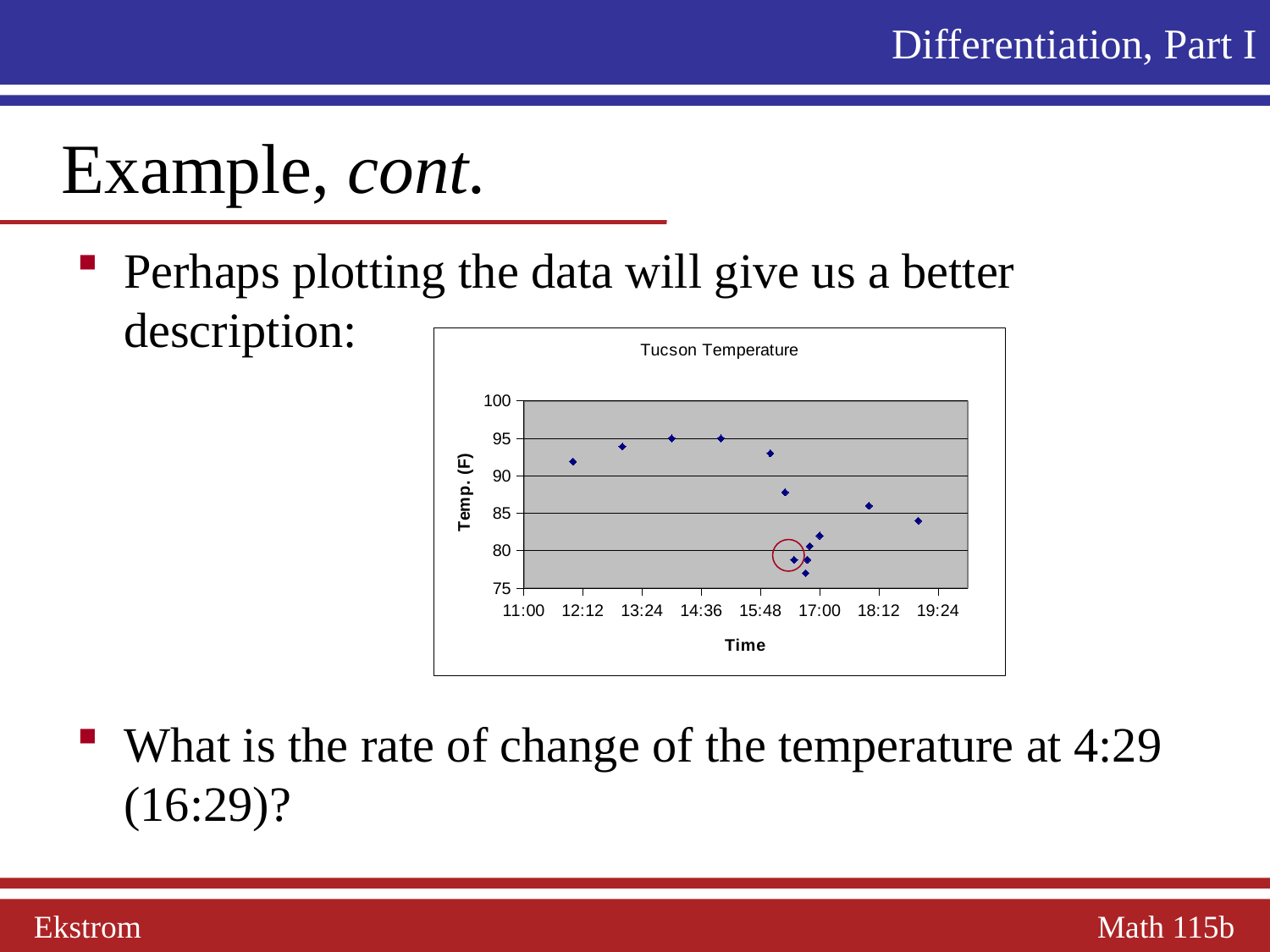
What kind of chart is shown on the slide? scatter plot Is the value of the rightmost data point (near 19:00) greater or less than 90? less What is the label of the vertical axis of the chart? Temp. (F) Which is larger, the temperature of the leftmost data point or the temperature of the rightmost data point? the leftmost data point Is the value of the data point near 18:00 greater or less than 90? less Is the value of the circled data point greater or less than 85? less Do the temperatures rise or fall between 12:12 and 14:36? rise Which is larger, the temperature of the circled data point or the temperature of the data point near 18:00? the data point near 18:00 Do the temperatures rise or fall between 15:48 and 17:00? fall What is the title of the chart? Tucson Temperature